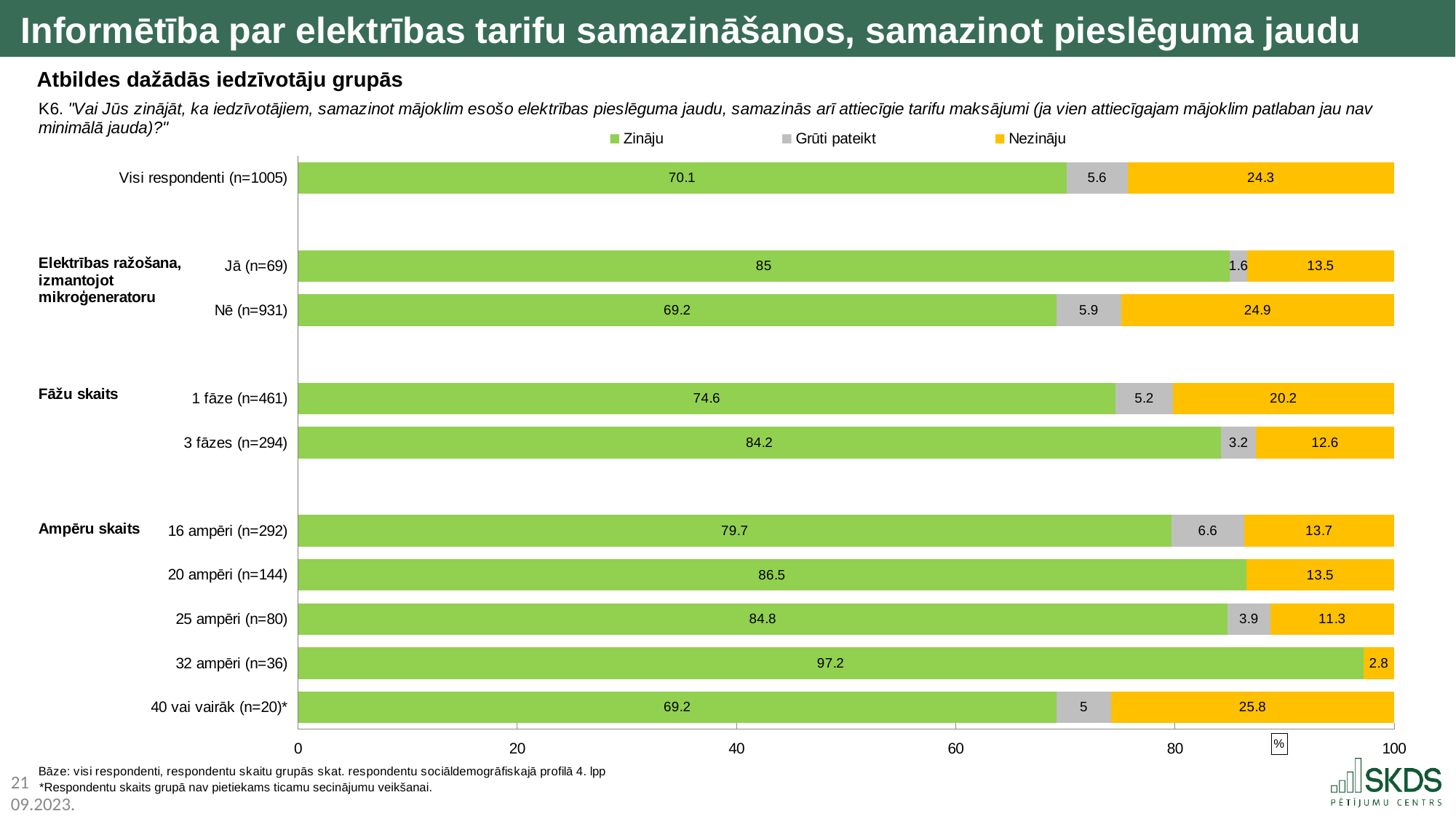
How many series does the legend list? 3 Which category has the highest Zināju value? 32 ampēri (n=36) What is the difference between the Zināju values for Jā (n=69) and Nē (n=931)? 15.8 What is the Grūti pateikt value for 16 ampēri (n=292)? 6.6 What is the total of the stacked bar for Visi respondenti (n=1005)? 100 Which has the larger Nezināju value, 1 fāze (n=461) or 3 fāzes (n=294)? 1 fāze (n=461) What is the Zināju value for Visi respondenti (n=1005)? 70.1 What kind of chart is shown on the slide? Stacked bar chart Is the Zināju value for 1 fāze (n=461) greater or less than 60? greater What is the Nezināju value for Nē (n=931)? 24.9 Which category has the lowest Nezināju value? 32 ampēri (n=36) How many respondent groups (bars) are shown in the chart? 10